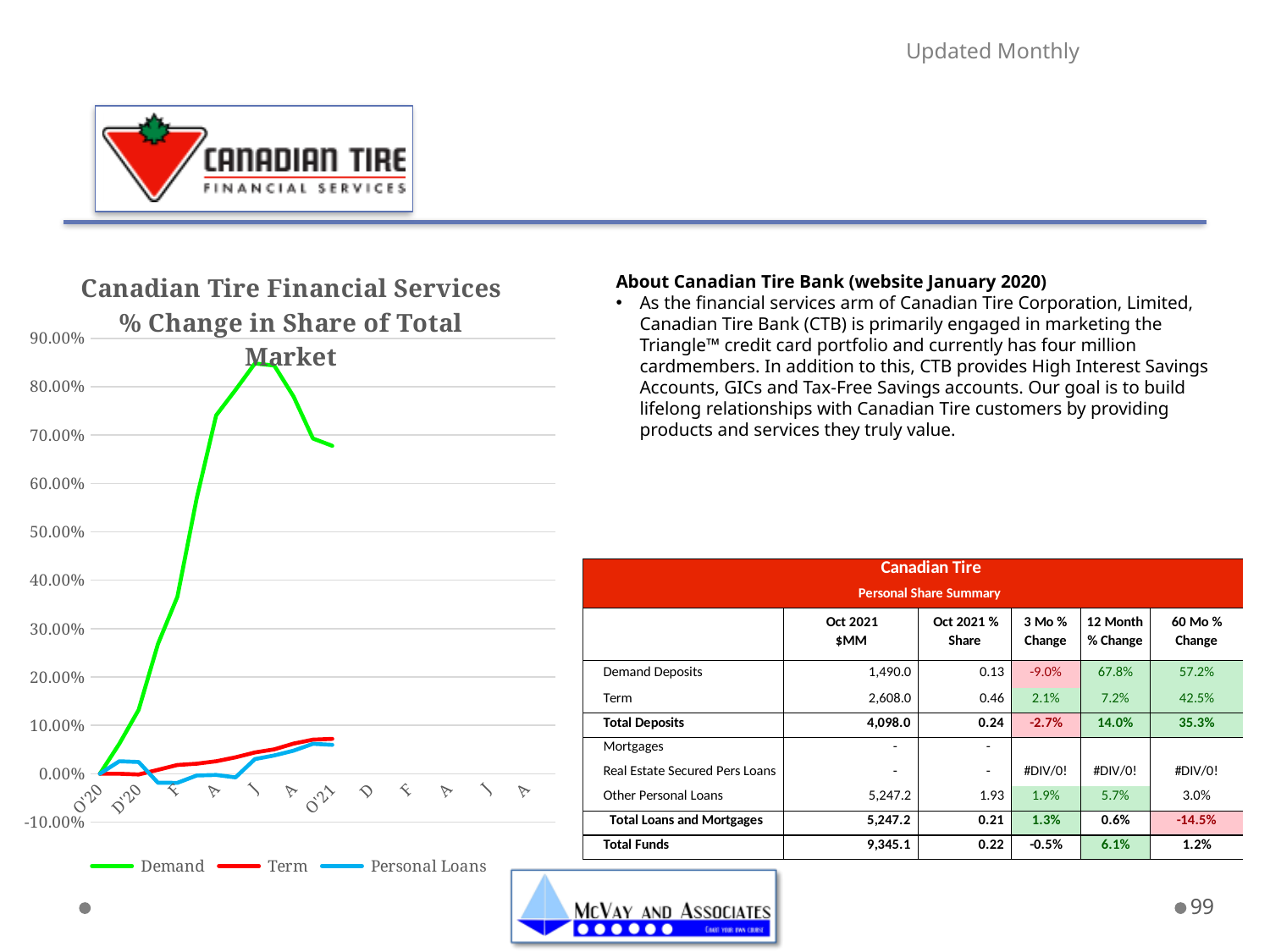
Does the Demand line rise or fall between O'20 and J (2021)? rise What are the series names listed in the chart legend? Demand, Term, Personal Loans How many category labels are shown along the x axis of the chart? 12 What colour is the Demand line in the chart? green At O'21, which series has the larger value, Demand or Term? Demand Is the peak value of the Demand line greater or less than 80.00%? greater Which series reaches the highest value on the chart? Demand What kind of chart is shown on the slide? line chart Does the Demand line rise or fall between its peak and O'21? fall Is the value of the Demand line at O'21 greater or less than 60.00%? greater How many series does the chart legend list? 3 Is the value of the Term line at O'21 greater or less than 10.00%? less